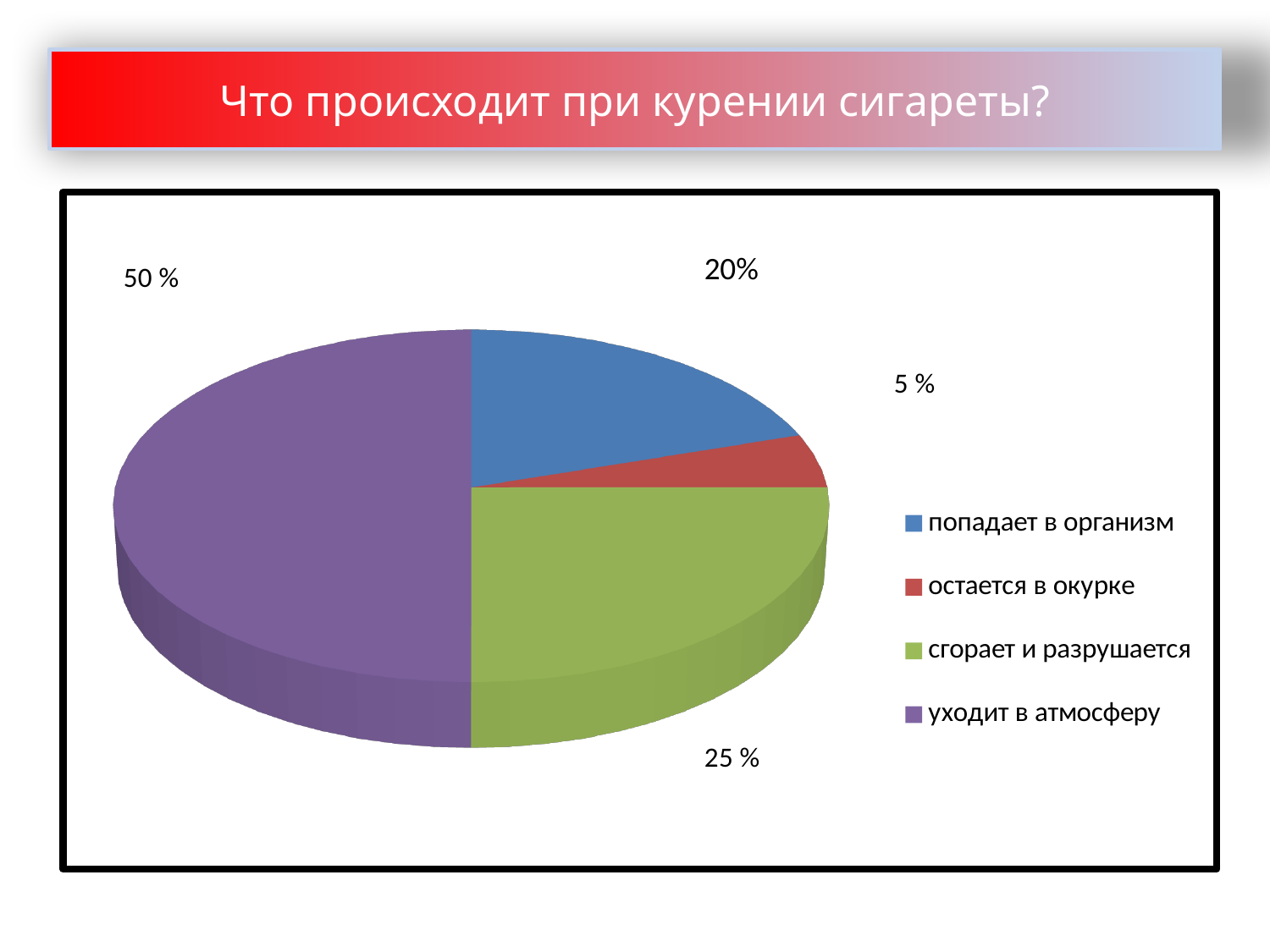
What share of the pie is labelled for 'остается в окурке'? 5 % What kind of chart is shown on the slide? pie chart Which category has the largest slice of the pie? уходит в атмосферу What share of the pie is labelled for 'сгорает и разрушается'? 25 % Which category has the smallest slice of the pie? остается в окурке What is the title of the slide above the chart? Что происходит при курении сигареты? How many slices does the pie chart have? 4 What is the difference between the share for 'уходит в атмосферу' and the share for 'сгорает и разрушается'? 25 % What colour is the slice for 'уходит в атмосферу'? purple Which is larger: the slice for 'сгорает и разрушается' or the slice for 'попадает в организм'? сгорает и разрушается What share of the pie is labelled for 'попадает в организм'? 20%